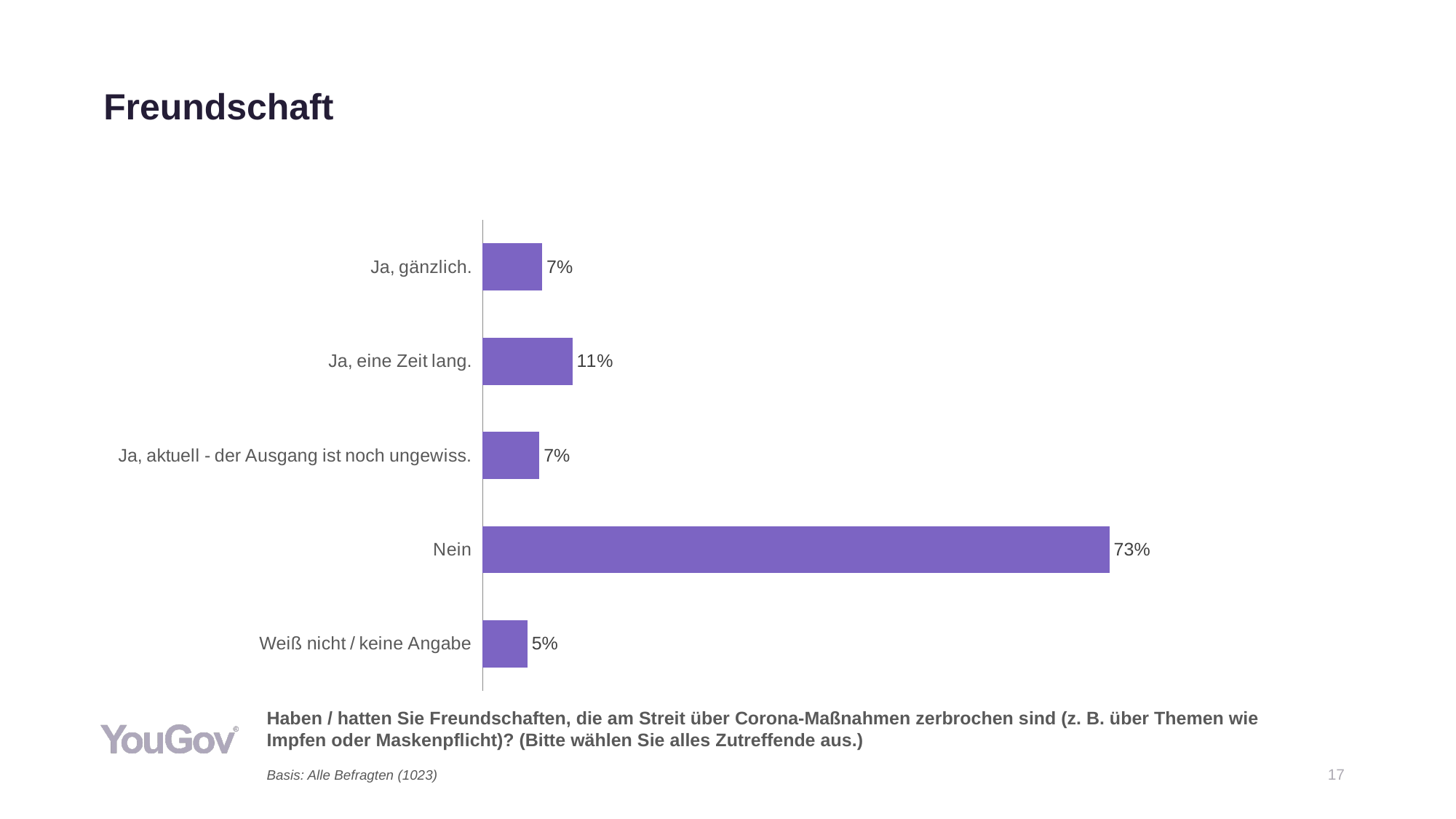
What is the value for "Nein"? 73% What is the difference between the values for "Nein" and "Ja, eine Zeit lang."? 62 percentage points What is the title of the slide? Freundschaft Which is larger, the value for "Ja, eine Zeit lang." or the value for "Ja, aktuell - der Ausgang ist noch ungewiss."? Ja, eine Zeit lang. What is the difference between the values for "Ja, gänzlich." and "Weiß nicht / keine Angabe"? 2 percentage points What is the value for "Weiß nicht / keine Angabe"? 5% What kind of chart is shown on the slide? Bar chart What is the value for "Ja, gänzlich."? 7% How many categories are shown in the chart? 5 Which category has the highest value? Nein What is the value for "Ja, eine Zeit lang."? 11% Which category has the lowest value? Weiß nicht / keine Angabe